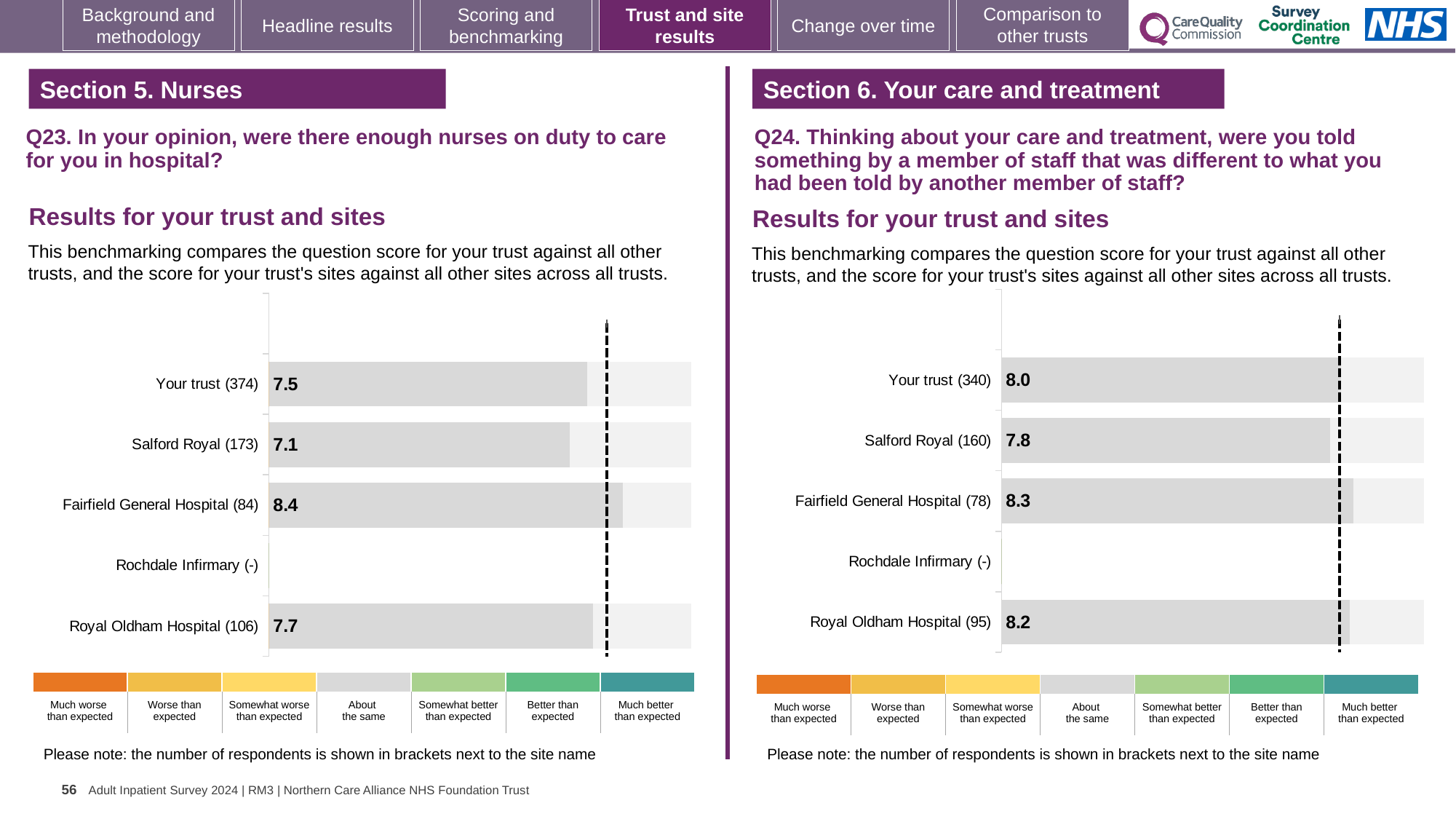
In the Q24 chart on the right, how many rows (trust and sites) are listed? 5 In the Q23 chart on the left, what is the difference between the scores for Fairfield General Hospital and Salford Royal? 1.3 In the Q23 chart on the left, which site has the highest score? Fairfield General Hospital In the Q24 chart on the right, which site has the highest score? Fairfield General Hospital In the Q23 chart on the left, which site has the lowest score among those with a score shown? Salford Royal What kind of chart is used for the Q23 results on the left? Bar chart In the Q23 chart on the left, how many respondents are shown for Royal Oldham Hospital? 106 In the Q24 chart on the right, what is the score for Your trust? 8.0 In the Q24 chart on the right, which is larger, the score for Salford Royal or the score for Royal Oldham Hospital? Royal Oldham Hospital In the Q23 chart on the left, what is the score for Salford Royal? 7.1 In the Q24 chart on the right, what is the score for Royal Oldham Hospital? 8.2 In the Q23 chart on the left, what is the score for Your trust? 7.5